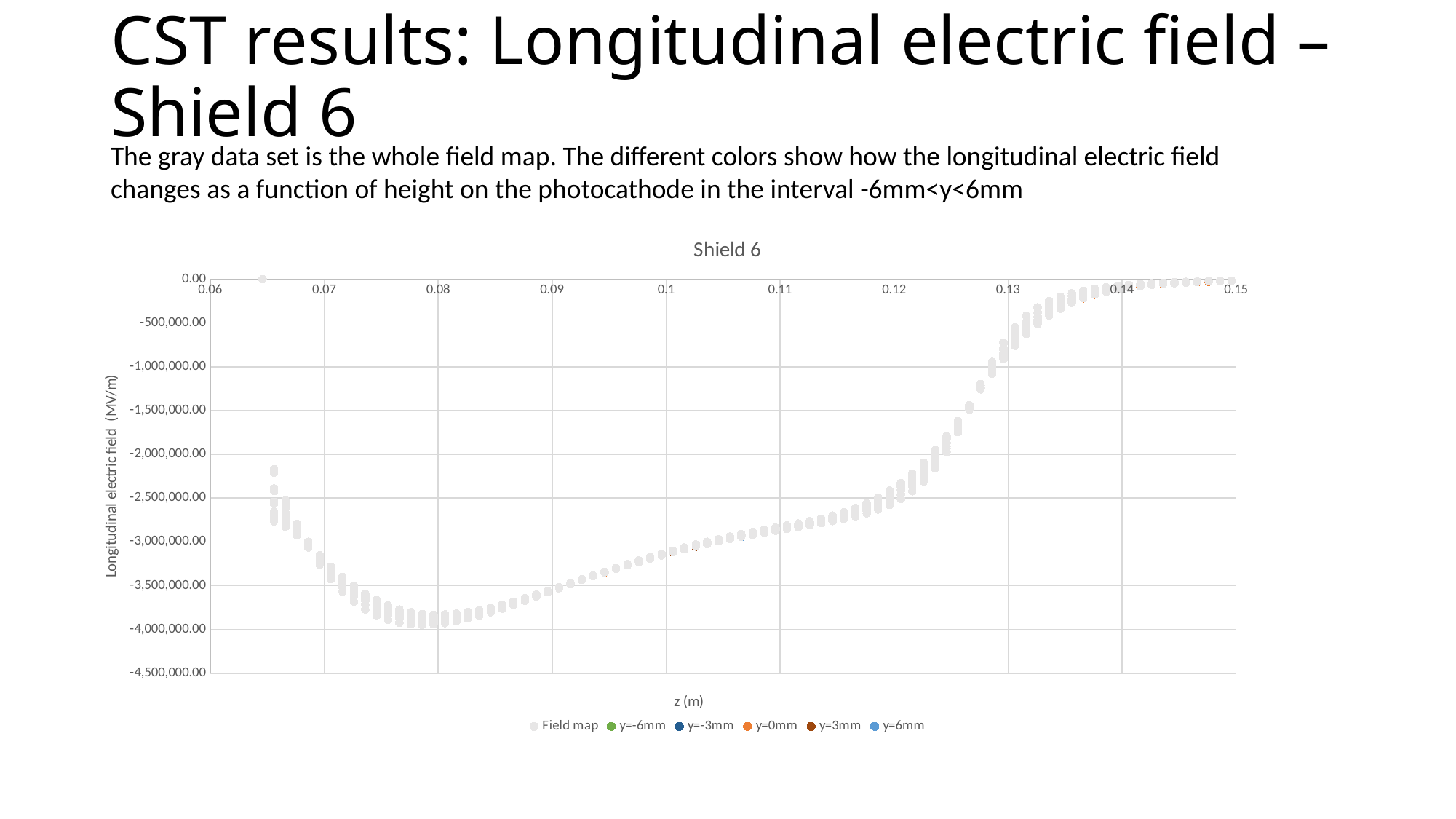
Is the Field map value at z = 0.12 greater or less than -3,000,000.00? greater Which is larger, the Field map value at z = 0.08 or at z = 0.1? z = 0.1 Is the Field map value at z = 0.11 greater or less than -2,500,000.00? less Is the Field map value at z = 0.1 greater or less than -3,500,000.00? greater What is the label of the x axis of the chart? z (m) Do the Field map values rise or fall as z increases from 0.08 to 0.15? rise How many series does the chart legend list? 6 Which is larger, the Field map value at z = 0.09 or at z = 0.13? z = 0.13 What is the title of the chart? Shield 6 What kind of chart is shown on the slide? scatter chart